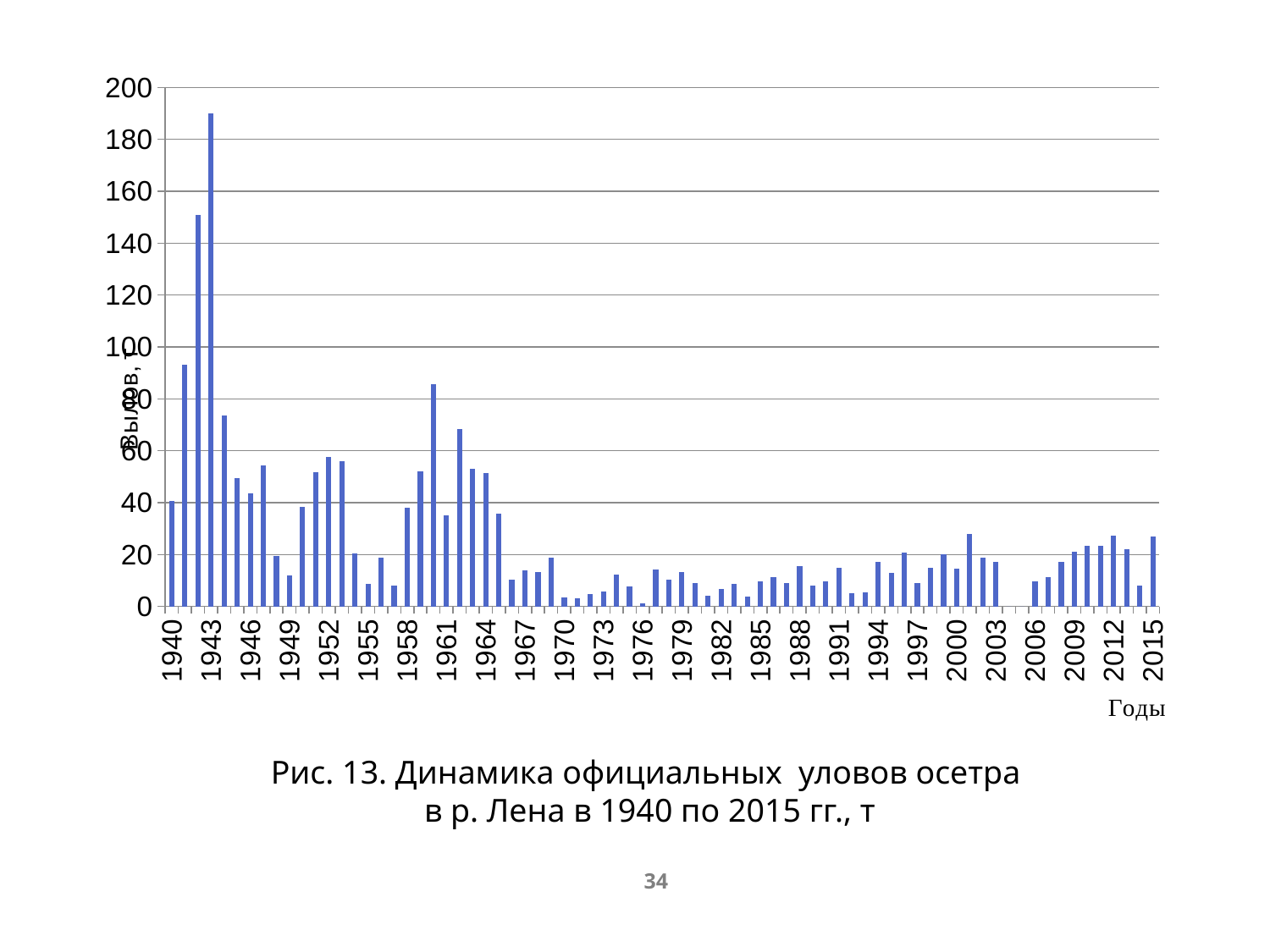
Is the value for 1964 greater or less than 40? greater What kind of chart is shown on the slide? bar chart Is the value for 2012 greater or less than 20? greater Which year has the larger value, 1952 or 1976? 1952 Which year has the highest catch value in the chart? 1943 Is the value for 1952 greater or less than 40? greater Which year has the larger value, 1943 or 1961? 1943 Overall, do the catch values rise or fall from the 1940s to 2015? fall What label is shown on the x axis of the chart? Годы